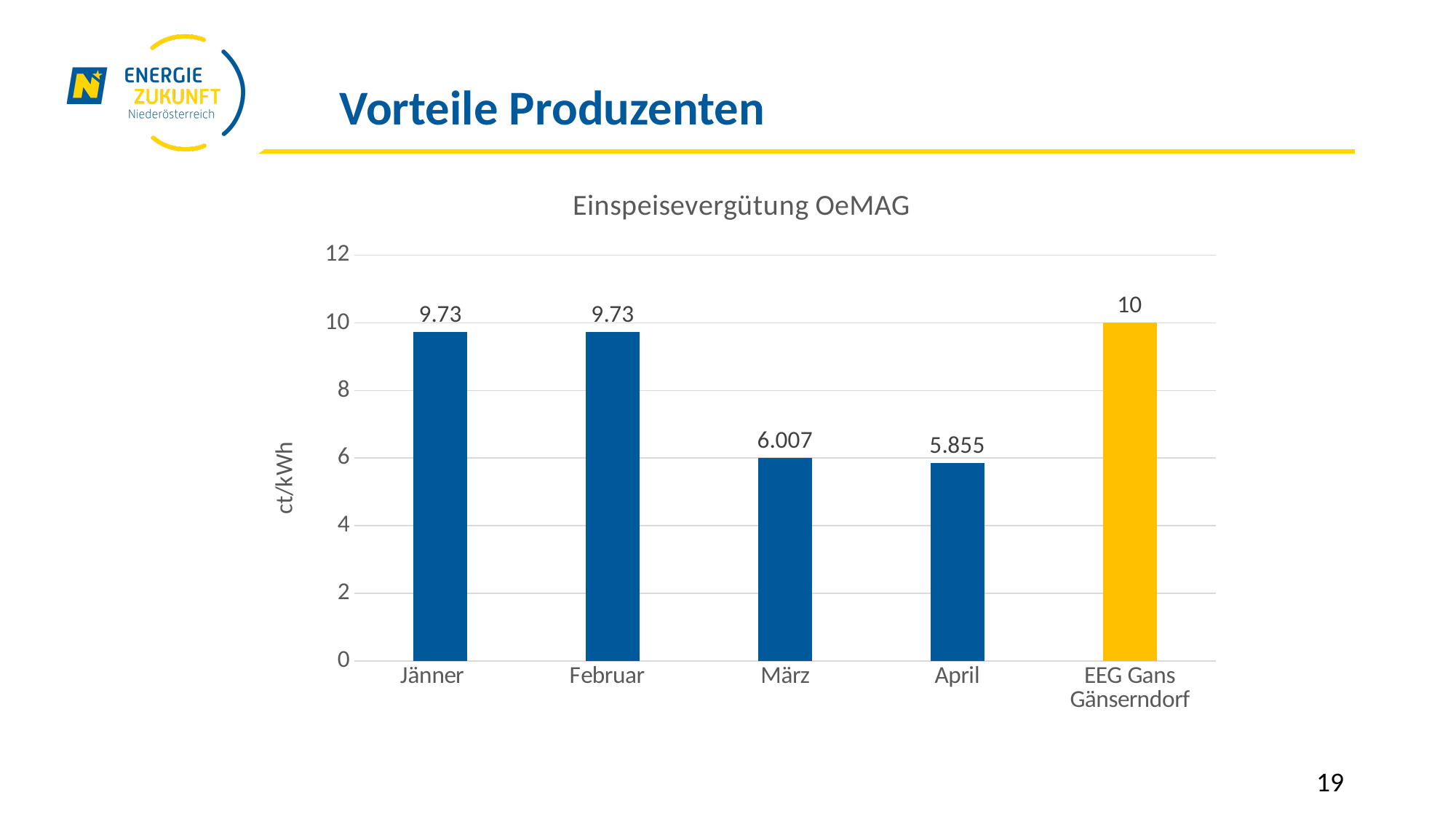
What is the value for EEG Gans Gänserndorf? 10 What is the difference between the values for Februar and März? 3.723 How many categories are shown on the x axis? 5 What is the value for März? 6.007 What kind of chart is this? Bar chart What is the title of the chart? Einspeisevergütung OeMAG What is the value for April? 5.855 Which category has the highest value? EEG Gans Gänserndorf Which category has the lowest value? April What is the value for Jänner? 9.73 Which is larger, the value for März or the value for April? März What is the difference between the values for EEG Gans Gänserndorf and April? 4.145